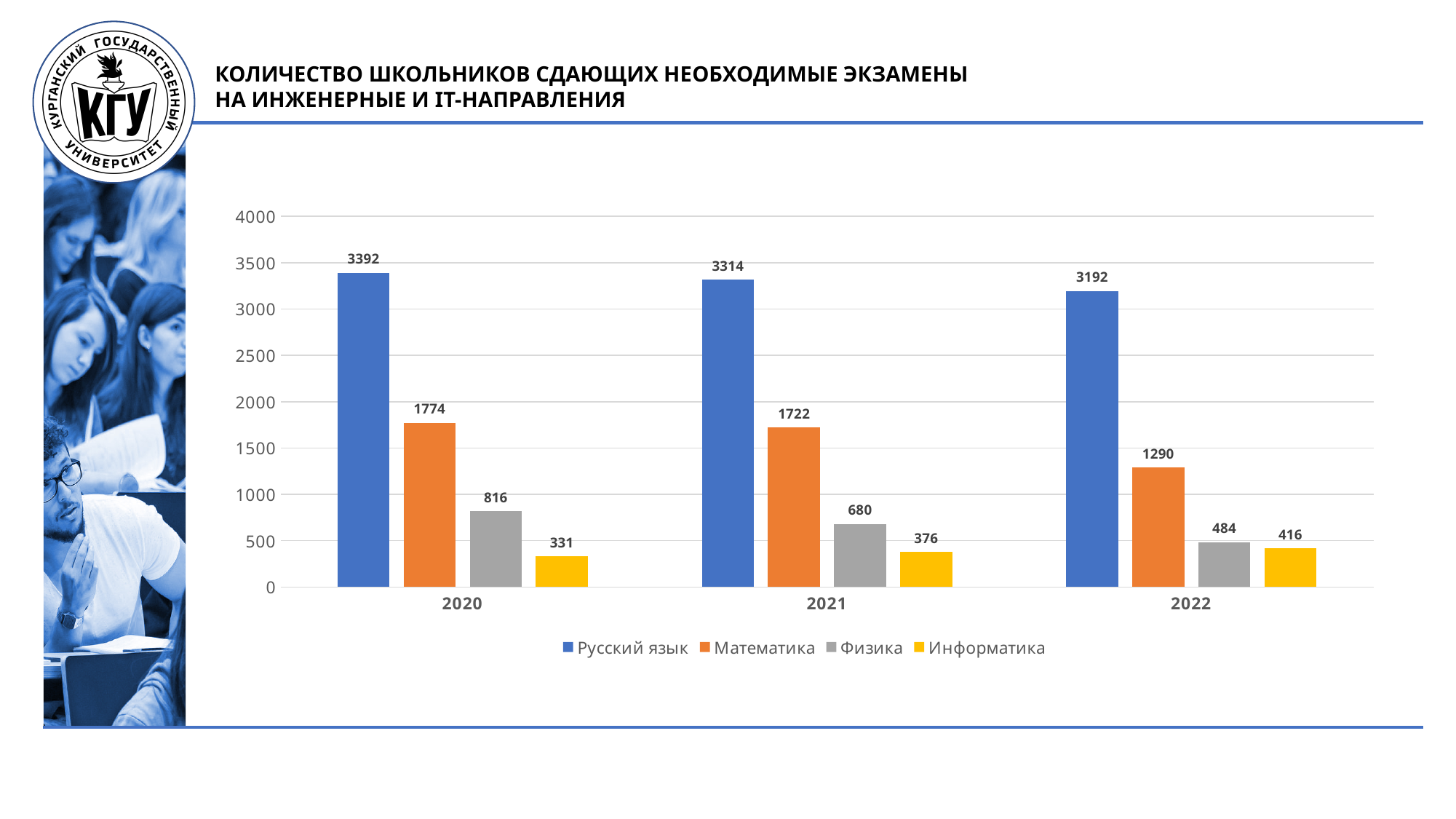
Which series has the highest value in 2022? Русский язык What is the value for Русский язык in 2020? 3392 Do the values for Математика rise or fall from 2020 to 2022? Fall How many series does the legend list? 4 What is the difference between Математика in 2020 and Математика in 2022? 484 What is the value for Информатика in 2022? 416 What kind of chart is shown on the slide? Bar chart What colour are the bars for Информатика? Yellow What is the value for Физика in 2021? 680 Which series has the lowest value in 2020? Информатика How many years are shown on the x axis? 3 Which is larger: Физика in 2022 or Информатика in 2022? Физика